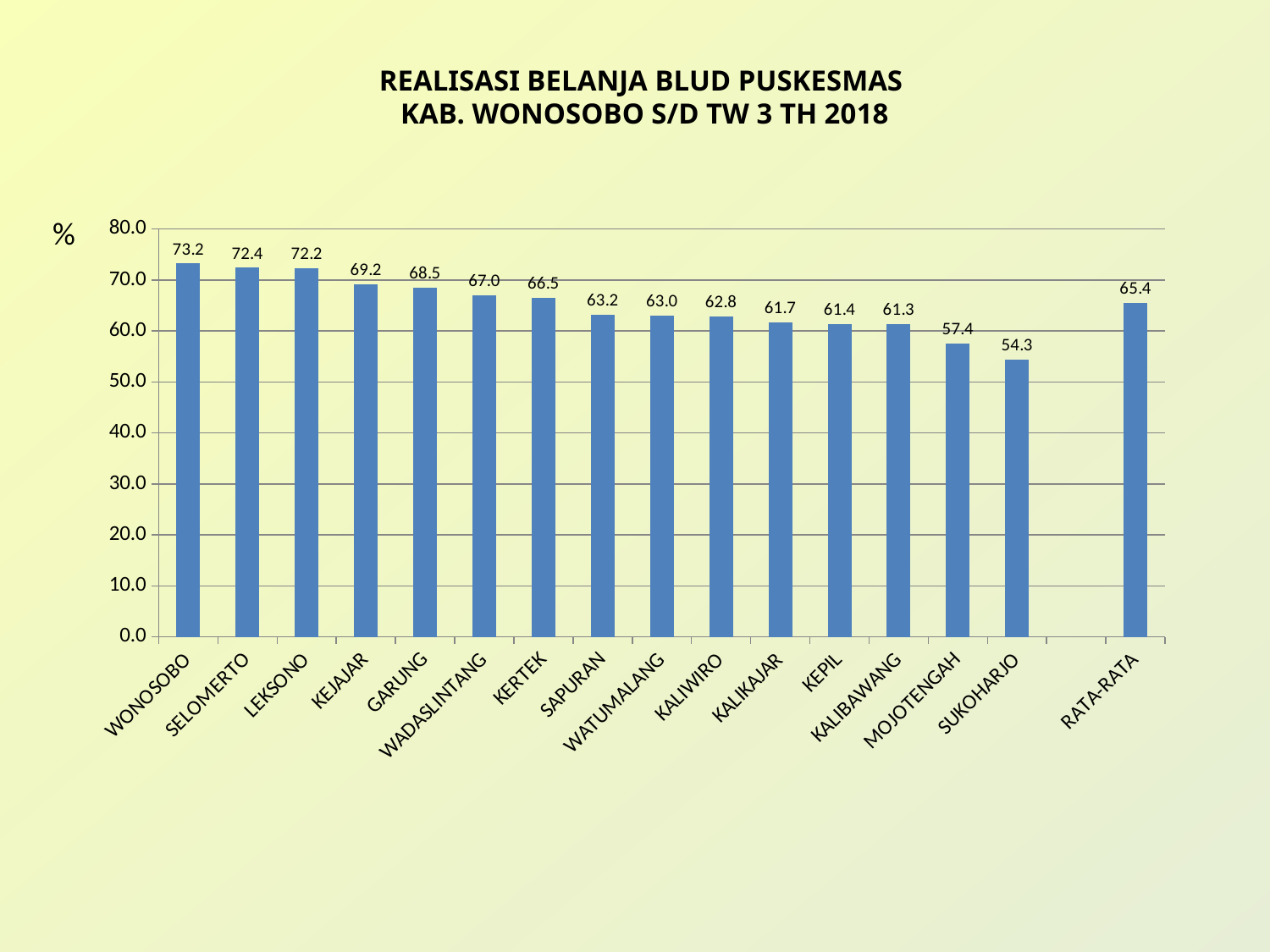
Which puskesmas has the lowest value? SUKOHARJO What is the title of the chart? REALISASI BELANJA BLUD PUSKESMAS KAB. WONOSOBO S/D TW 3 TH 2018 What is the difference between the values for WONOSOBO and SUKOHARJO? 18.9 What kind of chart is shown on the slide? Bar chart What is the value for KERTEK? 66.5 Which is larger, the value for GARUNG or the value for SAPURAN? GARUNG What is the value for WONOSOBO? 73.2 What is the difference between the values for KEJAJAR and MOJOTENGAH? 11.8 What is the value for RATA-RATA? 65.4 Which puskesmas has the highest value? WONOSOBO How many bars are shown in the chart, including RATA-RATA? 16 What is the value for SUKOHARJO? 54.3